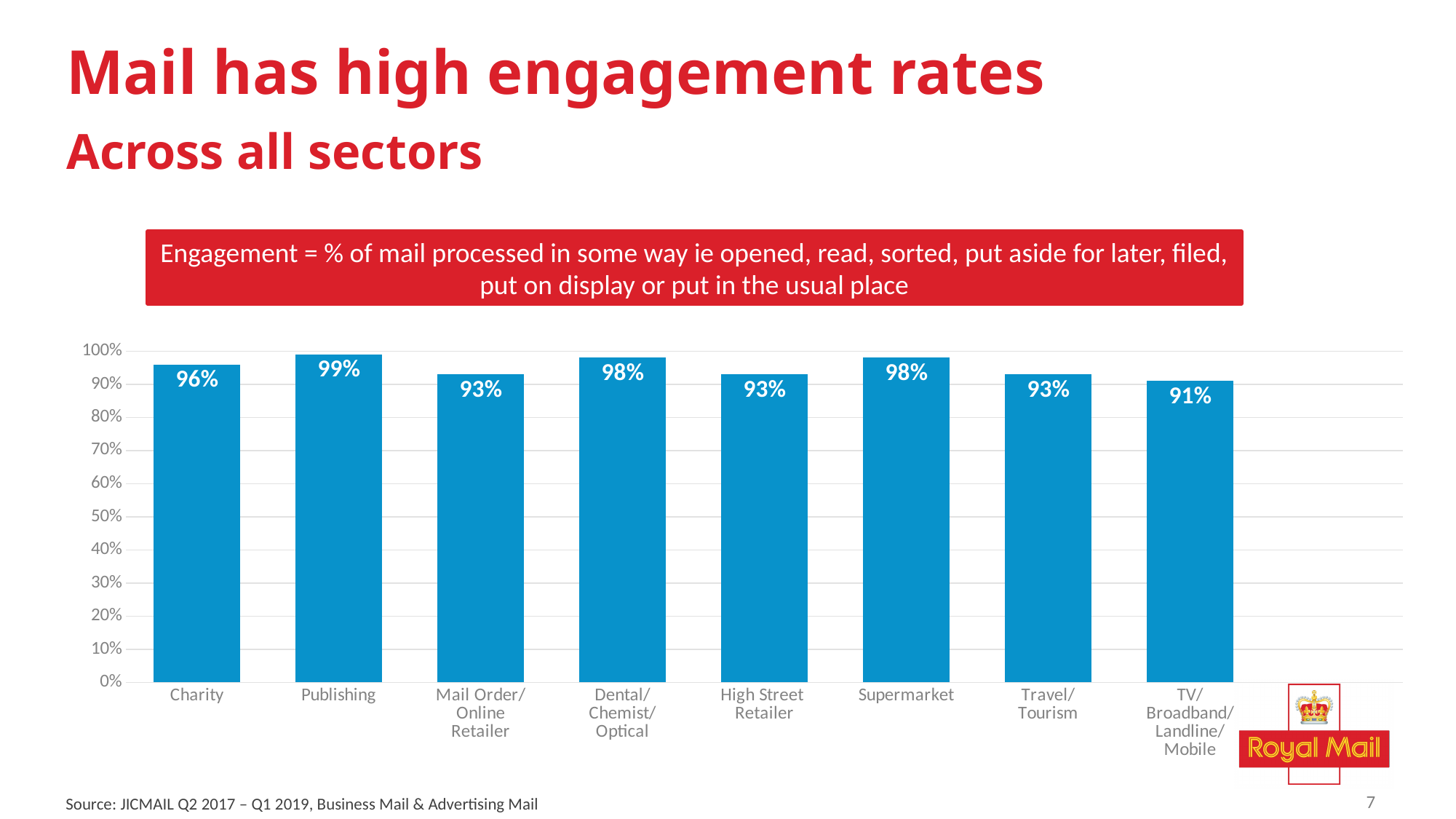
What is the difference between the engagement rates for Publishing and TV/Broadband/Landline/Mobile? 8% Which sector has the lowest engagement rate? TV/Broadband/Landline/Mobile Is the value for High Street Retailer greater or less than 90%? greater What is the engagement rate for TV/Broadband/Landline/Mobile? 91% What is the engagement rate for Supermarket? 98% Which sector has the highest engagement rate? Publishing What is the engagement rate for Charity? 96% What colour are the bars in the chart? Blue How many sectors are shown in the chart? 8 What is the engagement rate for Publishing? 99% Which has a higher engagement rate, Charity or Mail Order/Online Retailer? Charity What kind of chart is shown on the slide? Bar chart